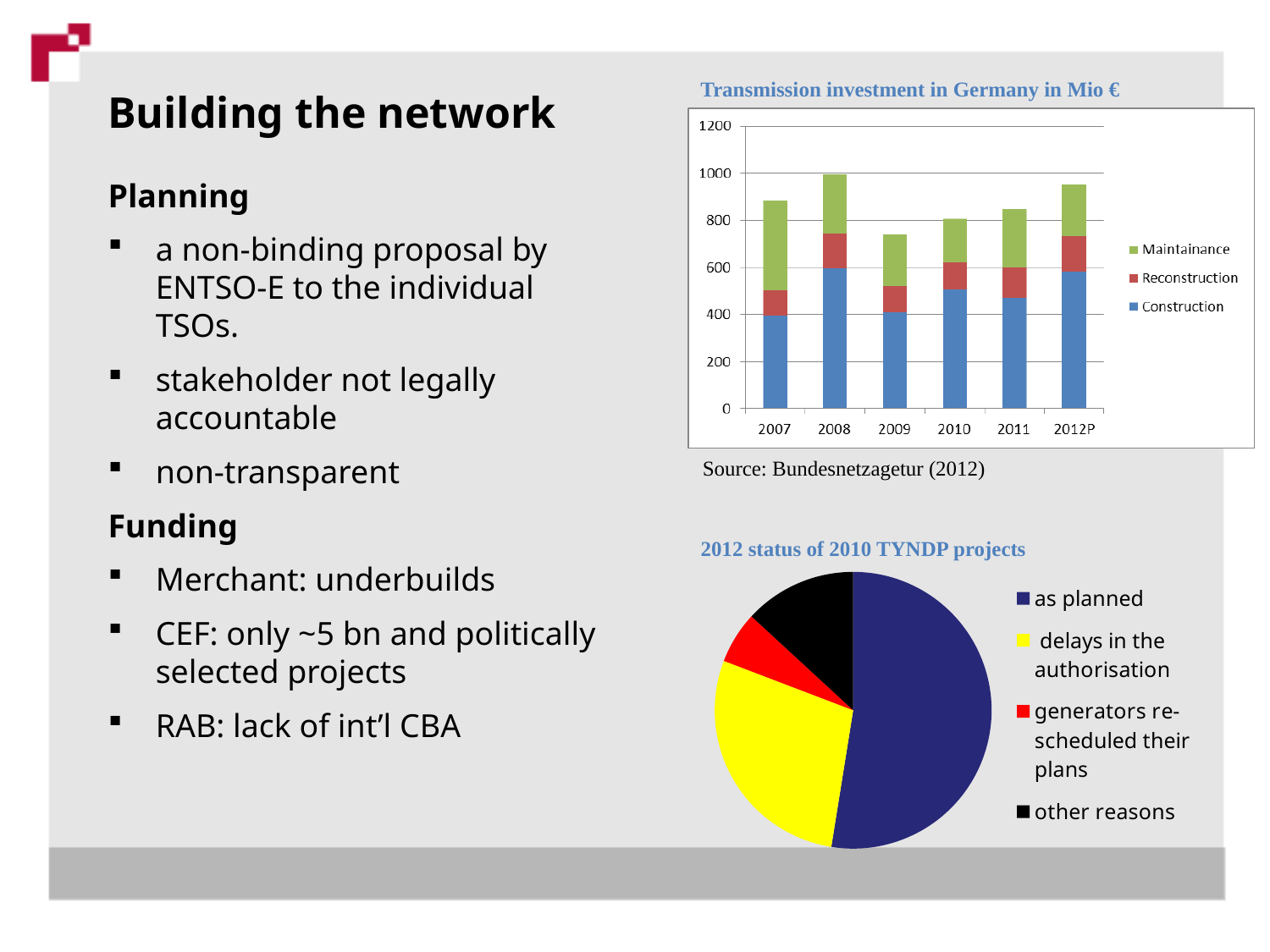
In the '2012 status of 2010 TYNDP projects' pie chart, which category has the largest slice? as planned In the 'Transmission investment in Germany in Mio €' chart, which series is shown in green? Maintainance In the 'Transmission investment in Germany in Mio €' chart, which year has the highest total investment? 2008 In the 'Transmission investment in Germany in Mio €' chart, which year has the lowest total investment? 2009 In the 'Transmission investment in Germany in Mio €' chart, is the total investment for 2008 greater or less than 800? greater In the '2012 status of 2010 TYNDP projects' pie chart, which is larger: 'delays in the authorisation' or 'other reasons'? delays in the authorisation What kind of chart is the 'Transmission investment in Germany in Mio €' chart? stacked bar chart In the 'Transmission investment in Germany in Mio €' chart, how many series does the legend list? 3 In the 'Transmission investment in Germany in Mio €' chart, how many years are shown on the x axis? 6 In the 'Transmission investment in Germany in Mio €' chart, is the total investment for 2009 greater or less than 800? less What kind of chart is the '2012 status of 2010 TYNDP projects' chart? pie chart In the 'Transmission investment in Germany in Mio €' chart, is the Construction value for 2010 greater or less than 400? greater